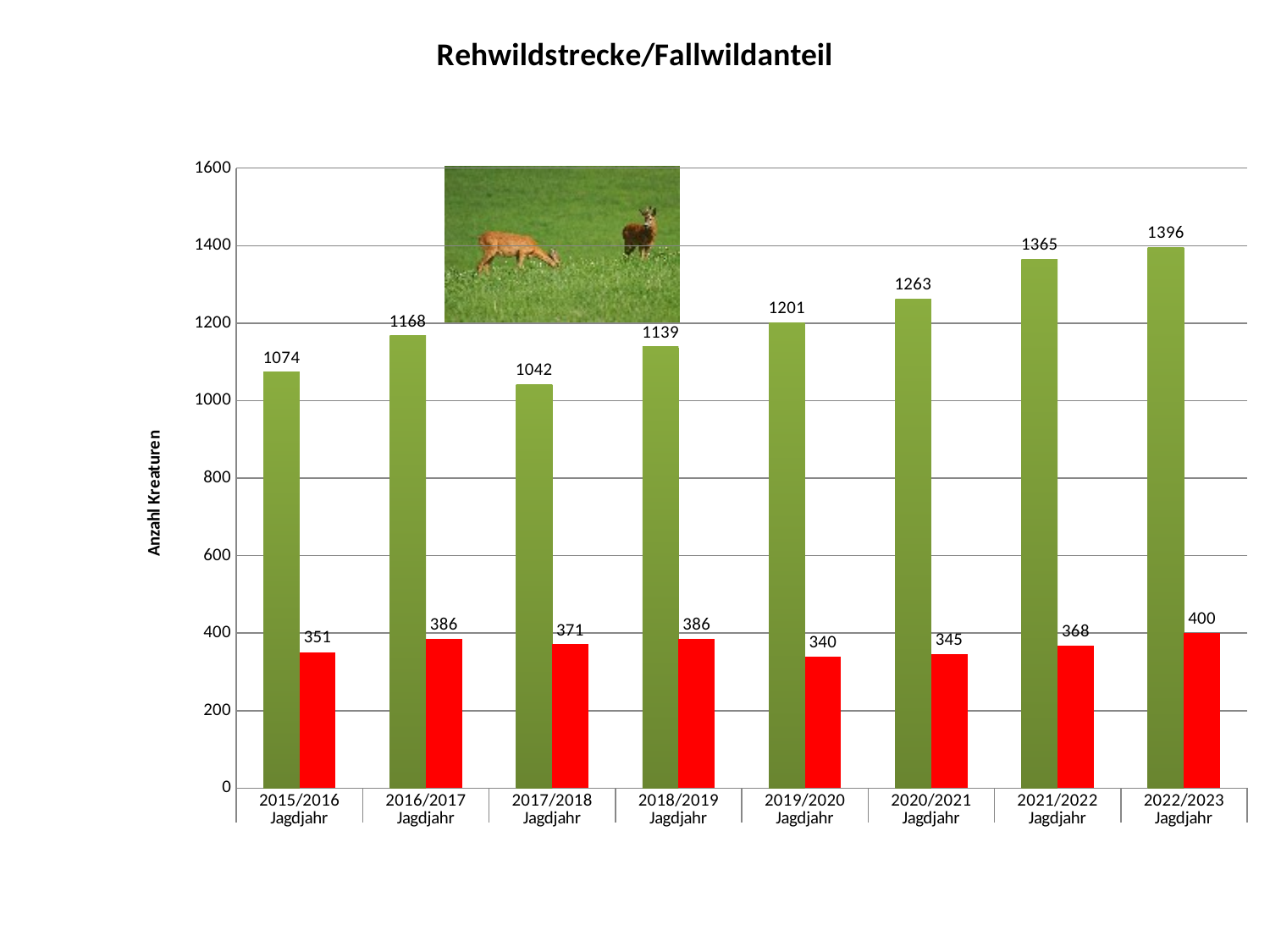
Which Jagdjahr has the lowest green bar? 2017/2018 Jagdjahr What is the difference between the green bar values for 2022/2023 Jagdjahr and 2015/2016 Jagdjahr? 322 Which Jagdjahr has the lowest red bar? 2019/2020 Jagdjahr What kind of chart is shown on the slide? Bar chart Which is larger, the green bar for 2016/2017 Jagdjahr or the green bar for 2018/2019 Jagdjahr? 2016/2017 Jagdjahr What is the value of the green bar for 2019/2020 Jagdjahr? 1201 What is the value of the green bar for 2015/2016 Jagdjahr? 1074 Which Jagdjahr has the highest green bar? 2022/2023 Jagdjahr How many Jagdjahr categories are shown on the x axis? 8 What is the title of the chart? Rehwildstrecke/Fallwildanteil What is the value of the red bar for 2022/2023 Jagdjahr? 400 What is the difference between the red bar values for 2022/2023 Jagdjahr and 2019/2020 Jagdjahr? 60